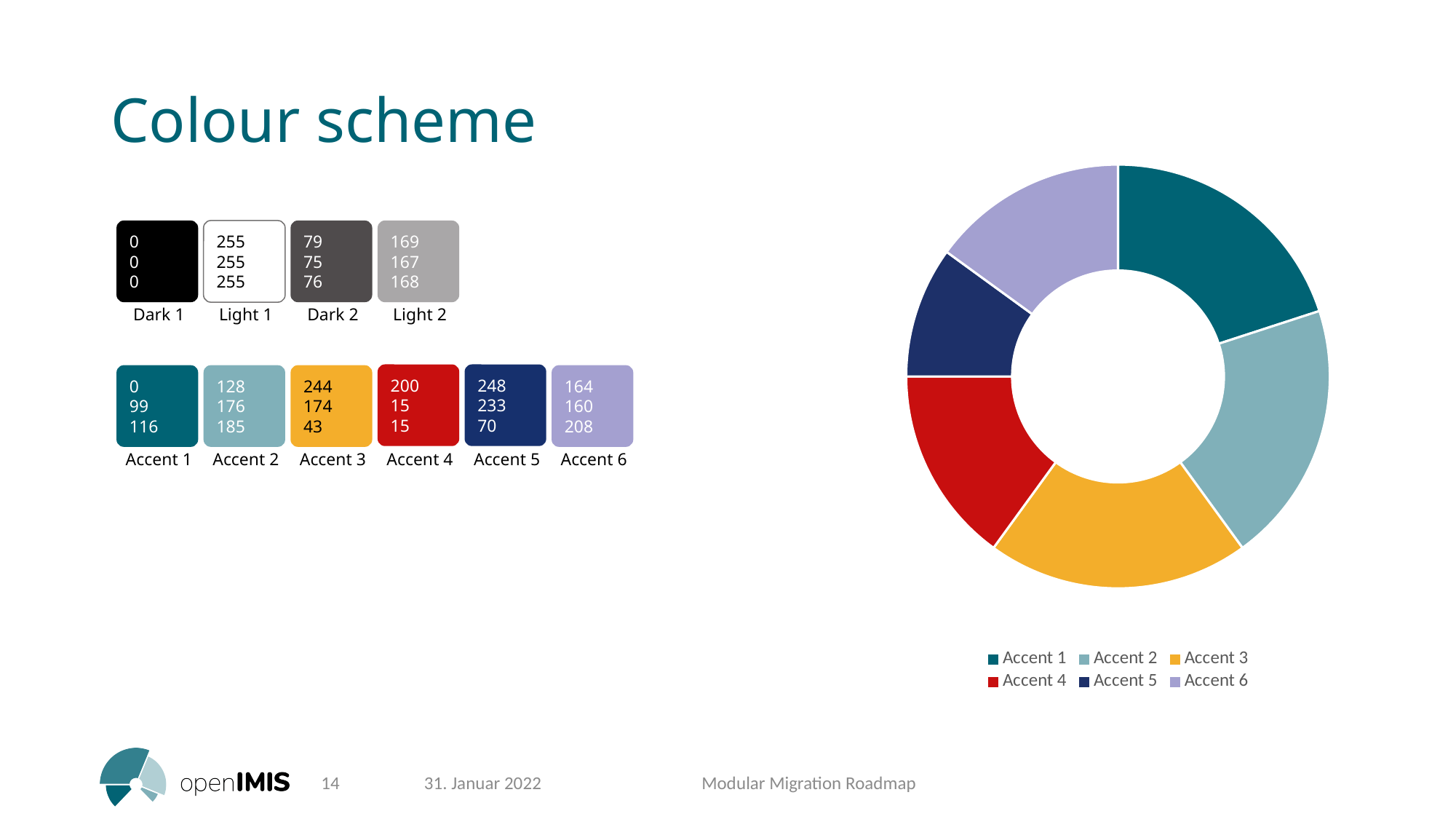
Which is larger in the doughnut chart, the Accent 2 slice or the Accent 5 slice? Accent 2 Which is larger in the doughnut chart, the Accent 3 slice or the Accent 5 slice? Accent 3 Which legend entry of the doughnut chart is shown in red? Accent 4 Which is larger in the doughnut chart, the Accent 3 slice or the Accent 4 slice? Accent 3 What colour is the Accent 3 slice in the doughnut chart? Orange/yellow How many entries does the legend of the doughnut chart list? 6 How many slices does the doughnut chart have? 6 What kind of chart is shown on the slide? Doughnut chart Which slice of the doughnut chart is the largest? Accent 1, Accent 2 and Accent 3 (tied)